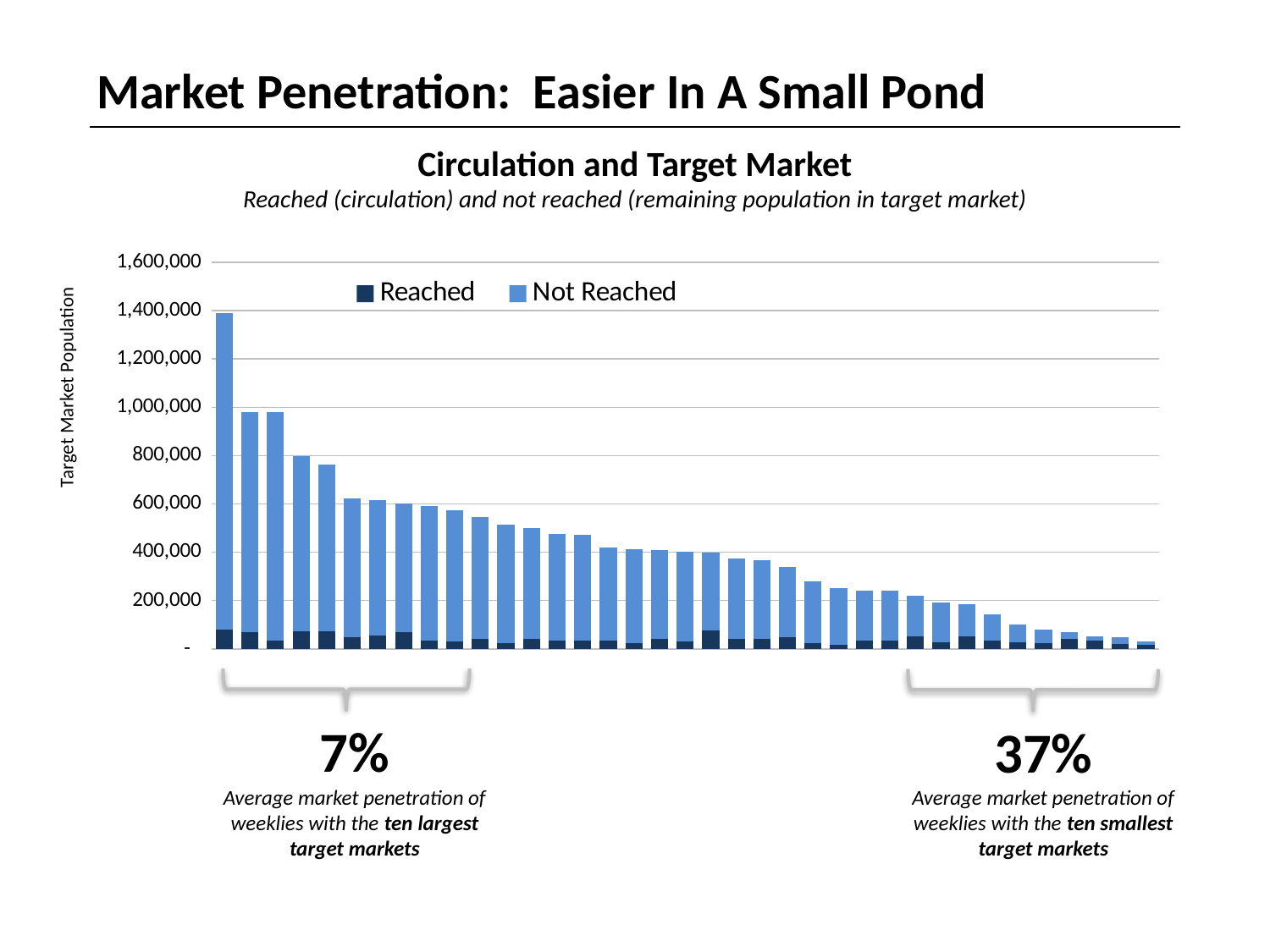
Do the total bar heights rise or fall moving from left to right along the x axis? fall What kind of chart is shown on the slide? stacked bar chart According to the annotation below the chart, what is the average market penetration of weeklies with the ten smallest target markets? 37% What is the highest value shown on the chart's vertical axis? 1,600,000 Is the total value of the fourth bar from the left greater or less than 600,000? greater Which bar has the largest total target market population? the leftmost (first) bar How many series does the chart's legend list? 2 Is the total value of the leftmost bar greater or less than 1,200,000? greater Is the total value of the rightmost bar greater or less than 200,000? less Is the total value of the leftmost bar greater or less than the total value of the second bar from the left? greater What are the two series named in the chart's legend? Reached and Not Reached